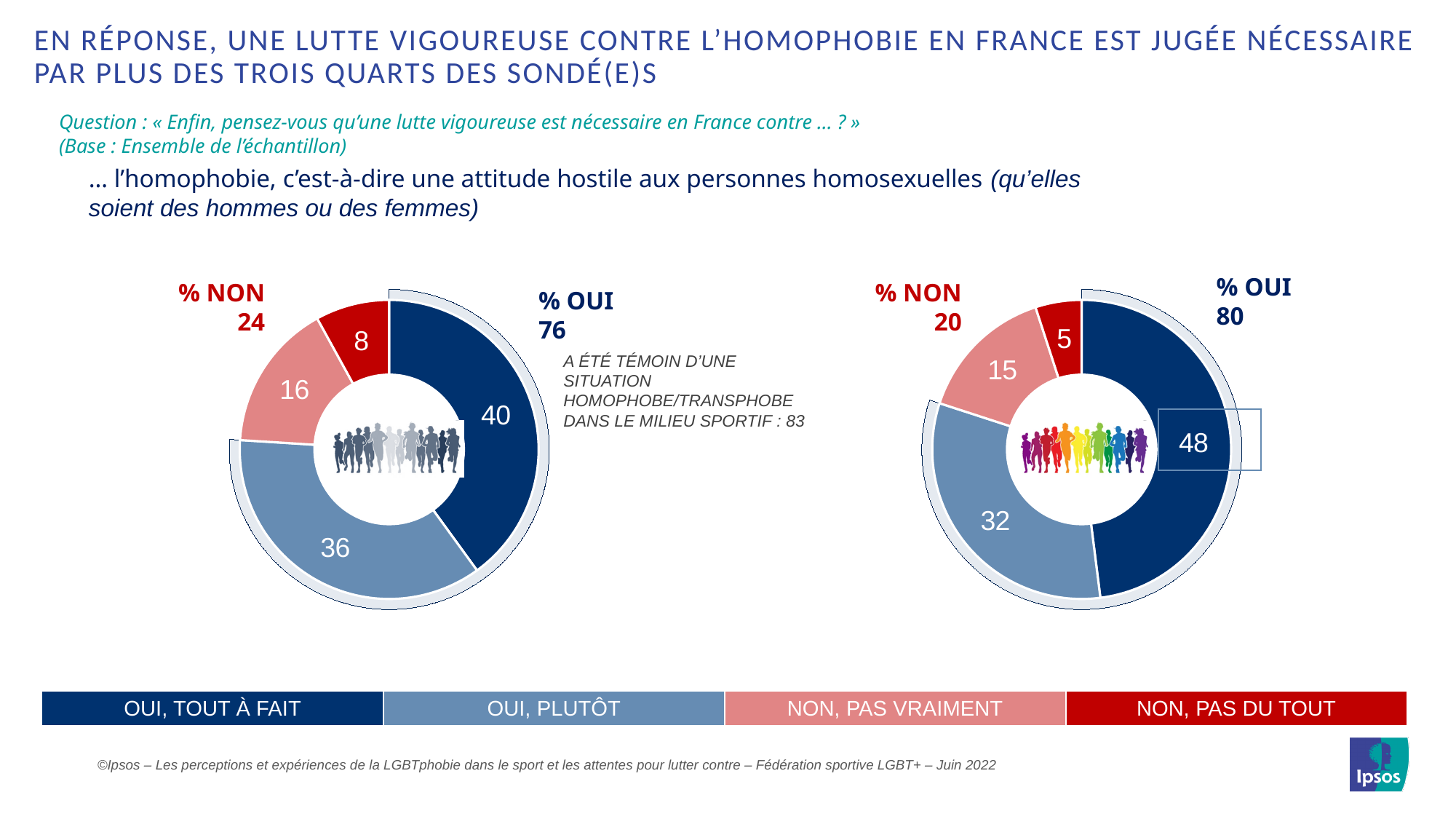
How many categories does the legend at the bottom of the slide list? 4 In the left donut chart, what is the difference between the values for "OUI, TOUT À FAIT" and "OUI, PLUTÔT"? 4 What is the total "% OUI" shown for the right donut chart? 80 In the right donut chart, which category has the largest value? OUI, TOUT À FAIT What is the total "% NON" shown for the left donut chart? 24 Which chart has the larger value for "OUI, TOUT À FAIT", the left chart or the right chart? the right chart In the left donut chart, what is the value for "OUI, TOUT À FAIT"? 40 In the left donut chart, which category has the smallest value? NON, PAS DU TOUT In the left donut chart, what is the value for "NON, PAS DU TOUT"? 8 What kind of chart is used on this slide? donut (pie) chart In the right donut chart, what is the value for "OUI, PLUTÔT"? 32 In the right donut chart, what is the value for "NON, PAS VRAIMENT"? 15